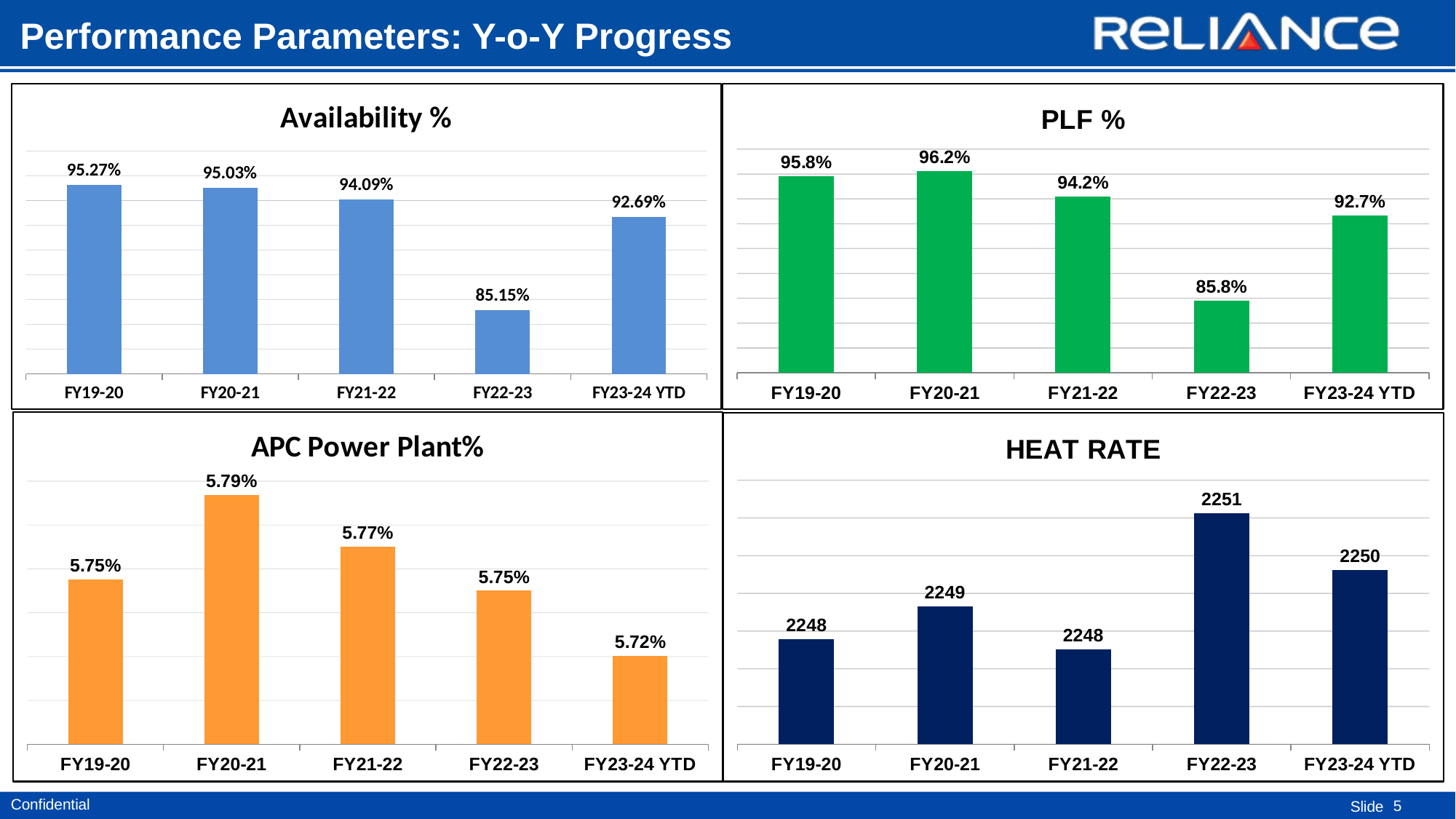
In the APC Power Plant% chart, what is the value for FY23-24 YTD? 5.72% In the PLF % chart, which fiscal year has the lowest value? FY22-23 In the HEAT RATE chart, what is the value for FY22-23? 2251 In the Availability % chart, which fiscal year has the highest value? FY19-20 In the Availability % chart, what is the value for FY22-23? 85.15% In the HEAT RATE chart, what is the difference between the FY22-23 and FY19-20 values? 3 How many fiscal year categories are shown in the HEAT RATE chart? 5 What type of chart is the APC Power Plant% chart? Bar chart In the Availability % chart, which is larger, the value for FY21-22 or FY23-24 YTD? FY21-22 In the PLF % chart, what is the value for FY20-21? 96.2% In the APC Power Plant% chart, which fiscal year has the highest value? FY20-21 In the PLF % chart, what is the difference between the FY20-21 and FY22-23 values? 10.4%